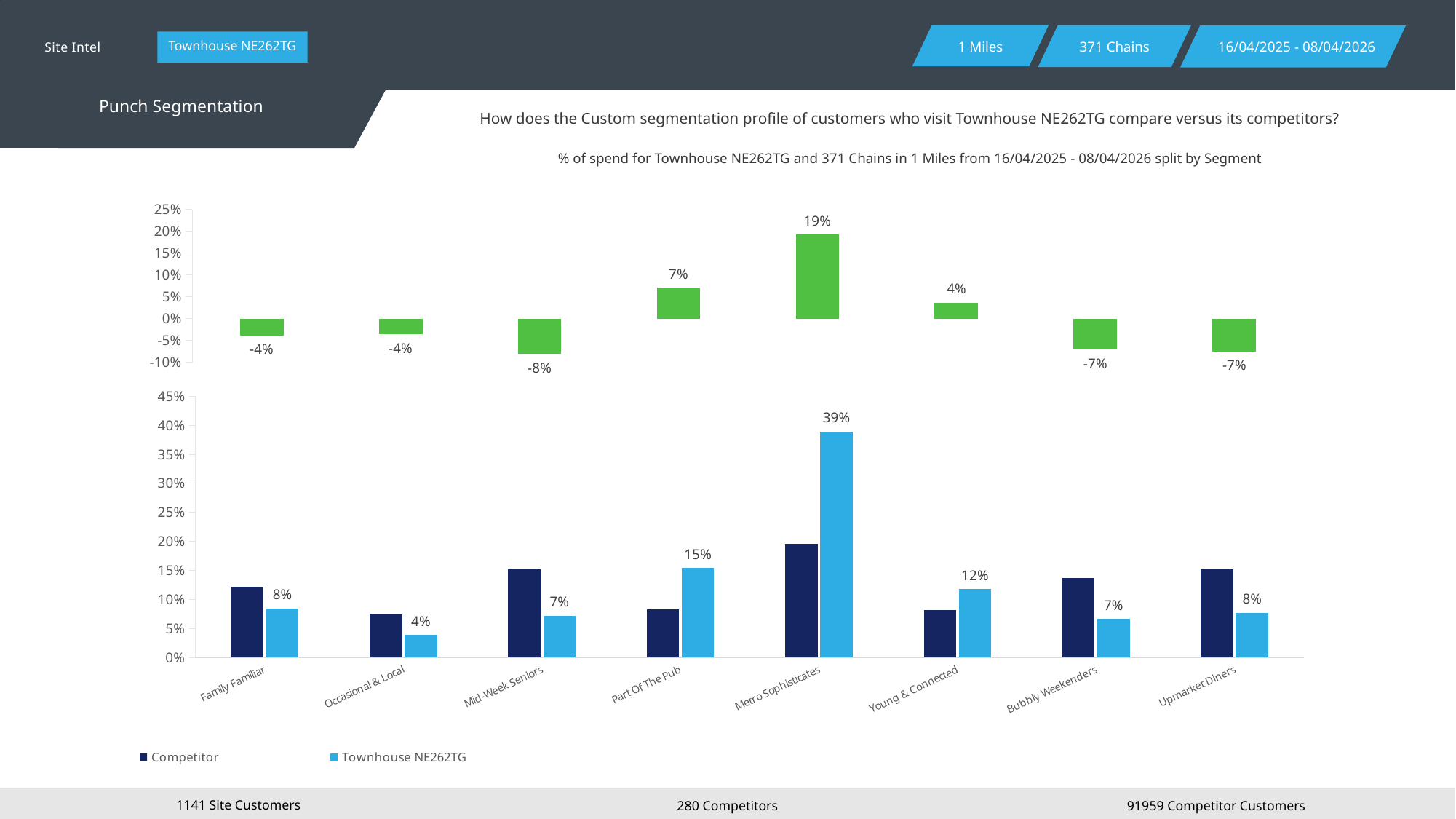
On the bottom chart, is the Competitor value for Upmarket Diners greater or less than 10%? greater On the bottom chart, which segment has the highest Townhouse NE262TG value? Metro Sophisticates On the bottom chart, what is the value for Townhouse NE262TG in the Metro Sophisticates segment? 39% On the bottom chart, is the Competitor value for Family Familiar greater or less than 10%? greater What type of chart is the bottom chart? bar chart How many series does the legend of the bottom chart list? 2 On the bottom chart, which segment has the lowest Townhouse NE262TG value? Occasional & Local How many segments are shown on the bottom chart? 8 On the top chart, what is the highest value shown? 19% On the bottom chart, what is the value for Townhouse NE262TG in the Part Of The Pub segment? 15% On the bottom chart, what is the difference between the Townhouse NE262TG values for Metro Sophisticates and Young & Connected? 27% On the bottom chart, in the Mid-Week Seniors segment, which series has the larger value, Competitor or Townhouse NE262TG? Competitor